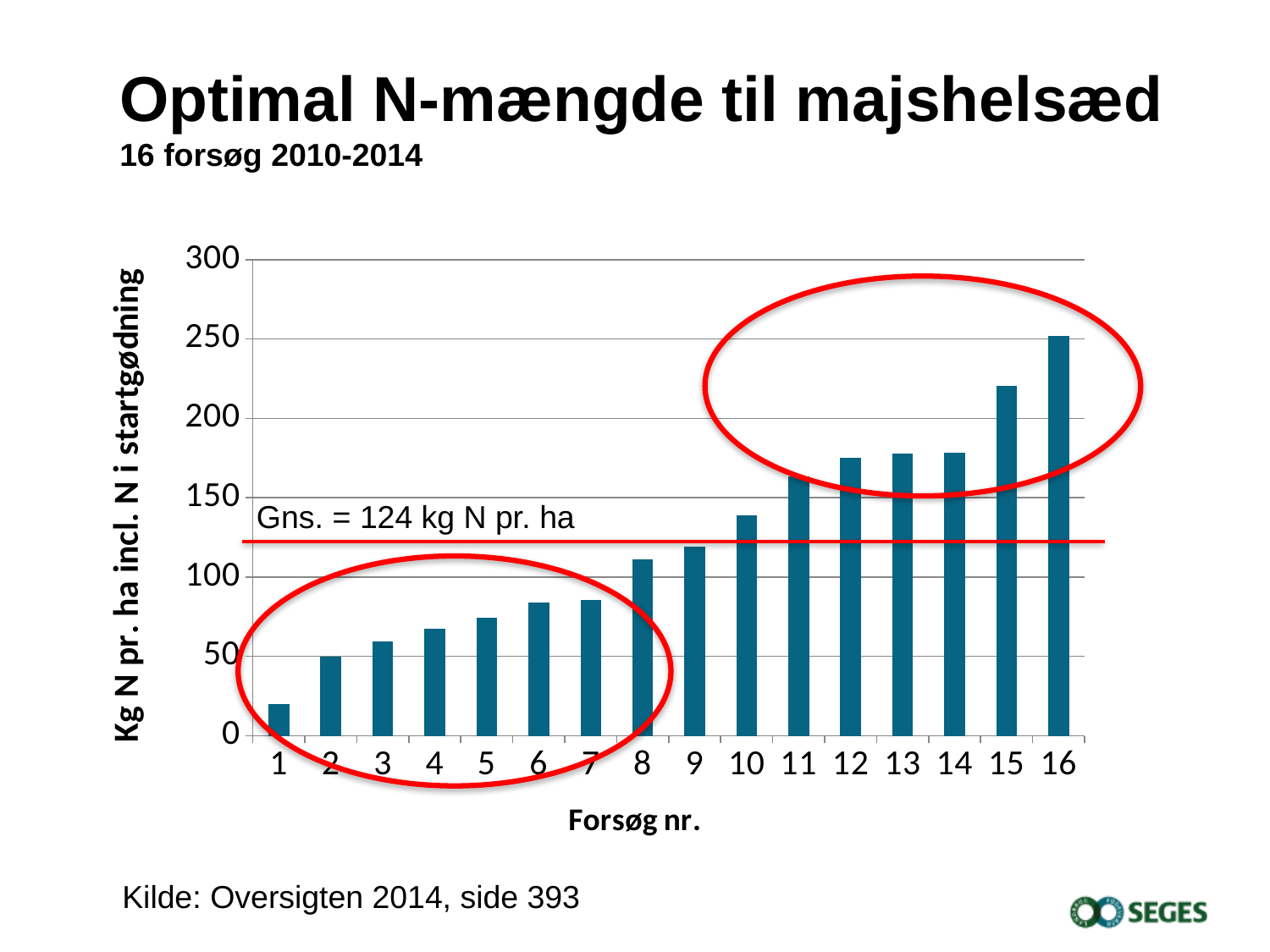
Do the bar values rise or fall from trial 1 to trial 16? rise Is the value for trial 10 greater or less than 150? less Is the value for trial 8 greater or less than 100? greater What average value is indicated by the red horizontal line? 124 kg N pr. ha How many trials (Forsøg nr.) are plotted on the x axis? 16 Which trial number has the highest optimal N amount? 16 Which has a larger value, trial 2 or trial 15? trial 15 What is the title of the x axis? Forsøg nr. Is the value for trial 1 greater or less than 50? less Which trial number has the lowest optimal N amount? 1 What kind of chart is shown on the slide? bar chart